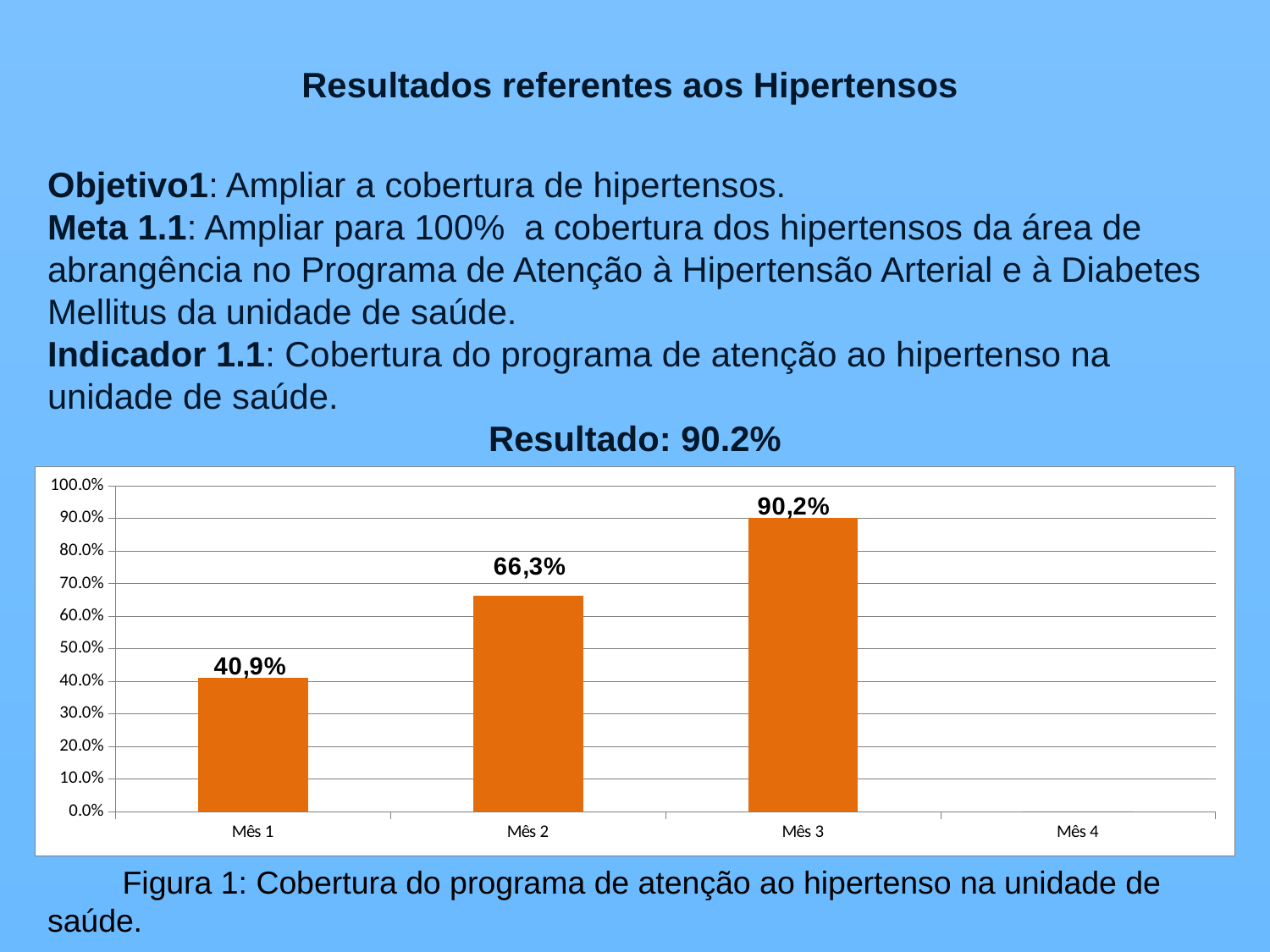
Is the value for Mês 1 greater or less than 50.0%? less Which month has the highest value? Mês 3 Among Mês 1, Mês 2 and Mês 3, which has the lowest value? Mês 1 Do the values rise or fall from Mês 1 to Mês 3? Rise What kind of chart is shown? Bar chart What is the value for Mês 2? 66,3% Which is larger, the value for Mês 1 or the value for Mês 2? Mês 2 What is the value for Mês 1? 40,9% What is the value for Mês 3? 90,2% How many categories are shown on the x axis? 4 What is the difference between the values for Mês 3 and Mês 2? 23,9% What is the difference between the values for Mês 2 and Mês 1? 25,4%